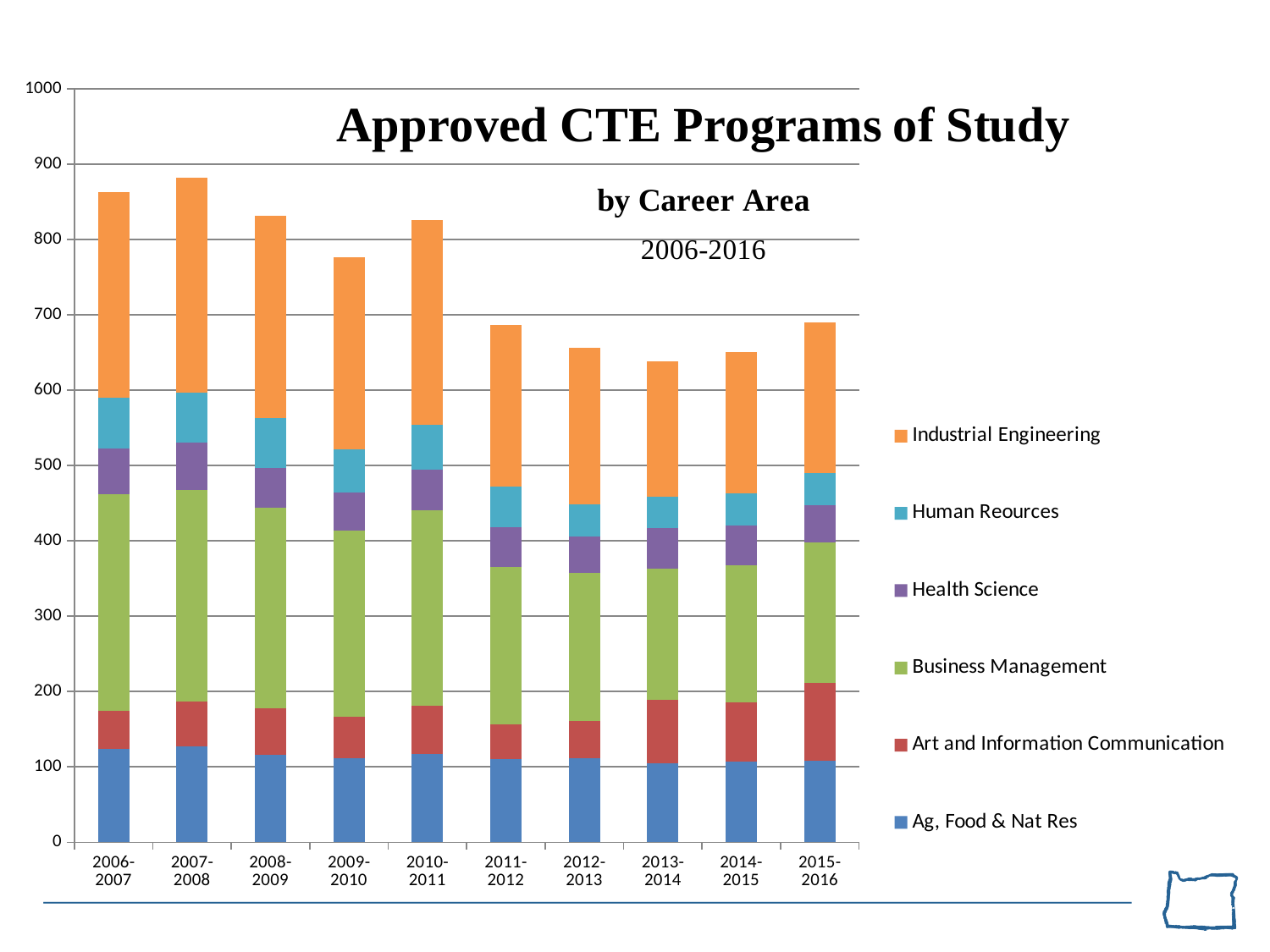
How many series does the legend list? 6 What is the title of the chart? Approved CTE Programs of Study by Career Area 2006-2016 Is the total bar height for 2012-2013 greater or less than 700? less Which series is shown in orange at the top of each stacked bar? Industrial Engineering Which school year has the tallest total bar? 2007-2008 What kind of chart is shown on the slide? Stacked bar chart Is the total bar height for 2009-2010 greater or less than 800? less How many school-year categories are shown along the x axis? 10 Do the total bar heights generally rise or fall from 2006-2007 to 2013-2014? fall Is the total bar height for 2007-2008 greater or less than 800? greater Which total bar is taller, 2006-2007 or 2011-2012? 2006-2007